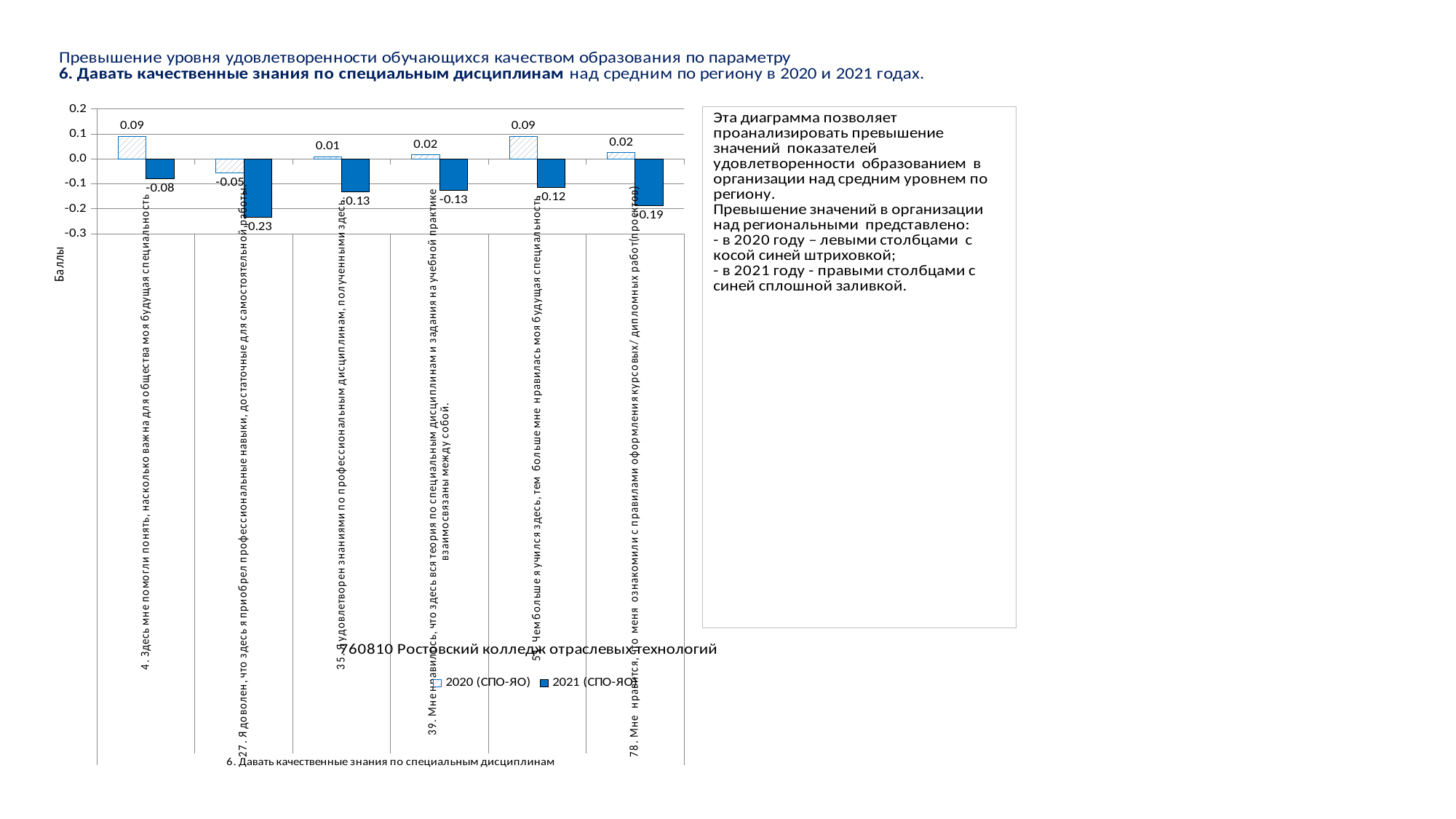
What is the difference between the 2020 and 2021 (СПО-ЯО) values for category 4 (Здесь мне помогли понять, насколько важна для общества моя будущая специальность)? 0.17 Which is larger for category 78: the 2020 (СПО-ЯО) value or the 2021 (СПО-ЯО) value? 2020 (СПО-ЯО) Which category has the lowest 2021 (СПО-ЯО) value? 27. Я доволен, что здесь я приобрел профессиональные навыки, достаточные для самостоятельной работы What is the label of the vertical axis of the chart? Баллы What is the 2021 (СПО-ЯО) value for category 27 (Я доволен, что здесь я приобрел профессиональные навыки, достаточные для самостоятельной работы)? -0.23 How many categories (questions) are plotted on the x axis? 6 Which category has the lowest 2020 (СПО-ЯО) value? 27. Я доволен, что здесь я приобрел профессиональные навыки, достаточные для самостоятельной работы What is the 2021 (СПО-ЯО) value for category 78 (Мне нравится, что меня ознакомили с правилами оформления курсовых/дипломных работ)? -0.19 What kind of chart is shown on the slide? bar chart How many series does the legend list? 2 What is the 2020 (СПО-ЯО) value for category 35 (Я удовлетворен знаниями по профессиональным дисциплинам, полученными здесь)? 0.01 What is the 2020 (СПО-ЯО) value for category 4 (Здесь мне помогли понять, насколько важна для общества моя будущая специальность)? 0.09